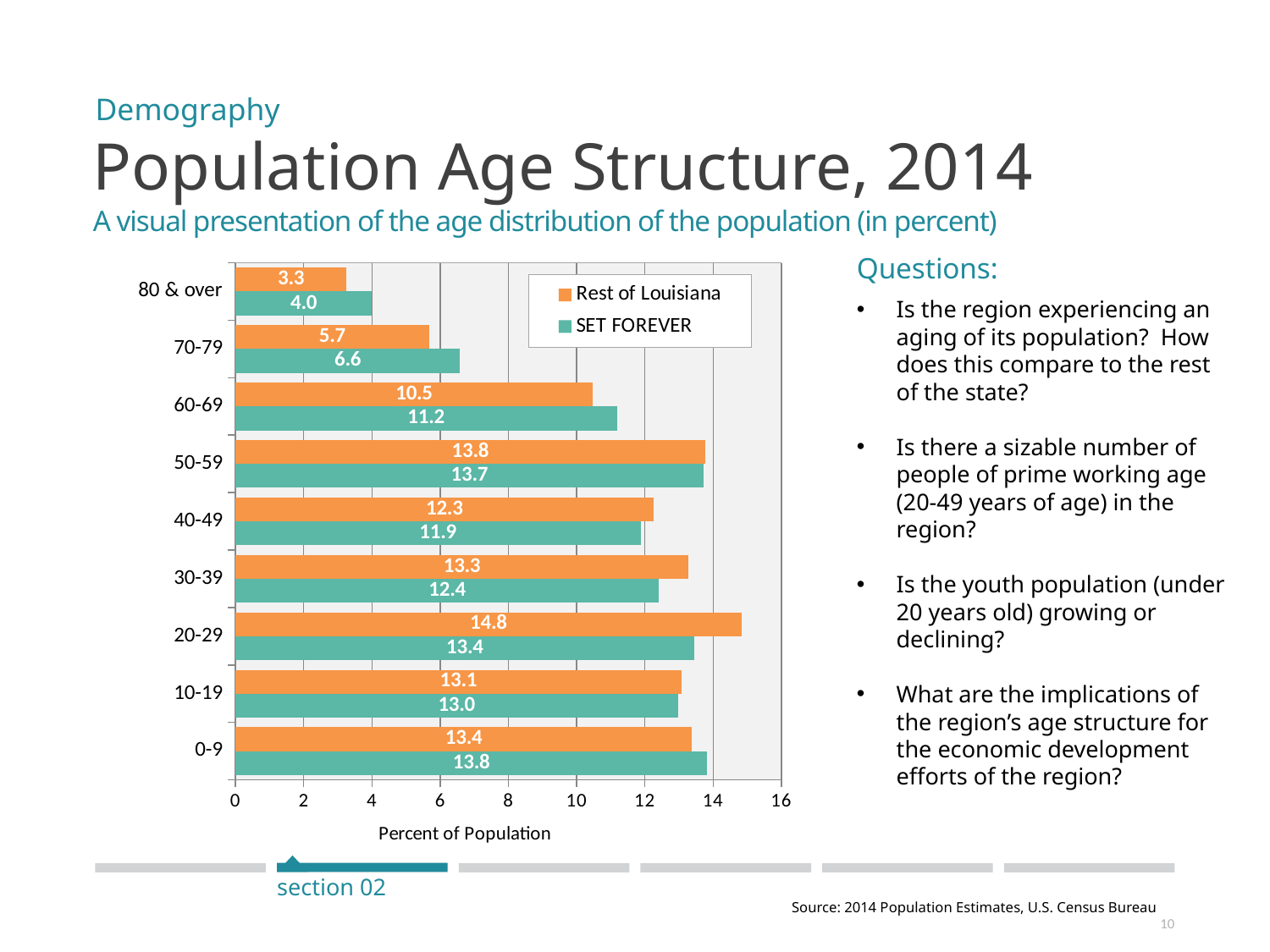
How many series does the legend list? 2 What is the difference between Rest of Louisiana and SET FOREVER in the 20-29 age group? 1.4 Which age group has the highest value for Rest of Louisiana? 20-29 In the 70-79 age group, which series has the larger value, Rest of Louisiana or SET FOREVER? SET FOREVER What is the value for Rest of Louisiana in the 20-29 age group? 14.8 What is the value for SET FOREVER in the 60-69 age group? 11.2 What kind of chart is shown on the slide? Bar chart How many age groups are shown on the chart? 9 What percent of the population is aged 80 & over in the Rest of Louisiana? 3.3 Which age group has the lowest value for SET FOREVER? 80 & over What is the label of the horizontal axis? Percent of Population Is the value for SET FOREVER in the 60-69 age group greater or less than 10? greater